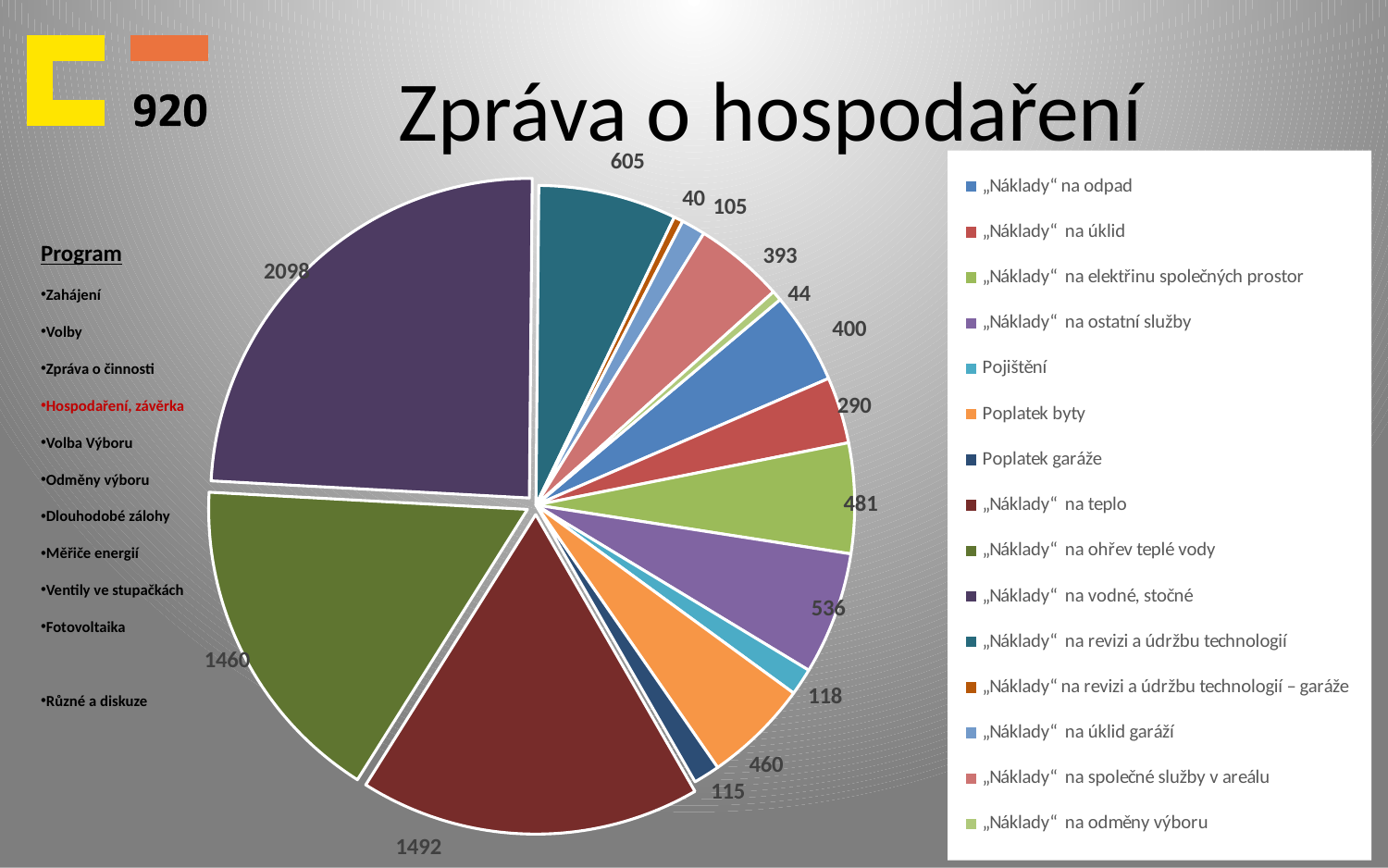
Which is larger, the value for „Náklady“ na odpad or the value for „Náklady“ na úklid? „Náklady“ na odpad What is the difference between the values for „Náklady“ na teplo and „Náklady“ na ohřev teplé vody? 32 How many slices does the pie chart have? 15 What kind of chart is shown on the slide? pie chart Which category has the largest slice in the pie chart? „Náklady“ na vodné, stočné How many entries does the legend of the pie chart list? 15 What is the title of the slide containing the pie chart? Zpráva o hospodaření Which category has the smallest slice in the pie chart? „Náklady“ na revizi a údržbu technologií – garáže What is the value for Pojištění in the pie chart? 118 What is the value for „Náklady“ na vodné, stočné in the pie chart? 2098 What is the value for Poplatek byty in the pie chart? 460 What is the value for „Náklady“ na teplo in the pie chart? 1492